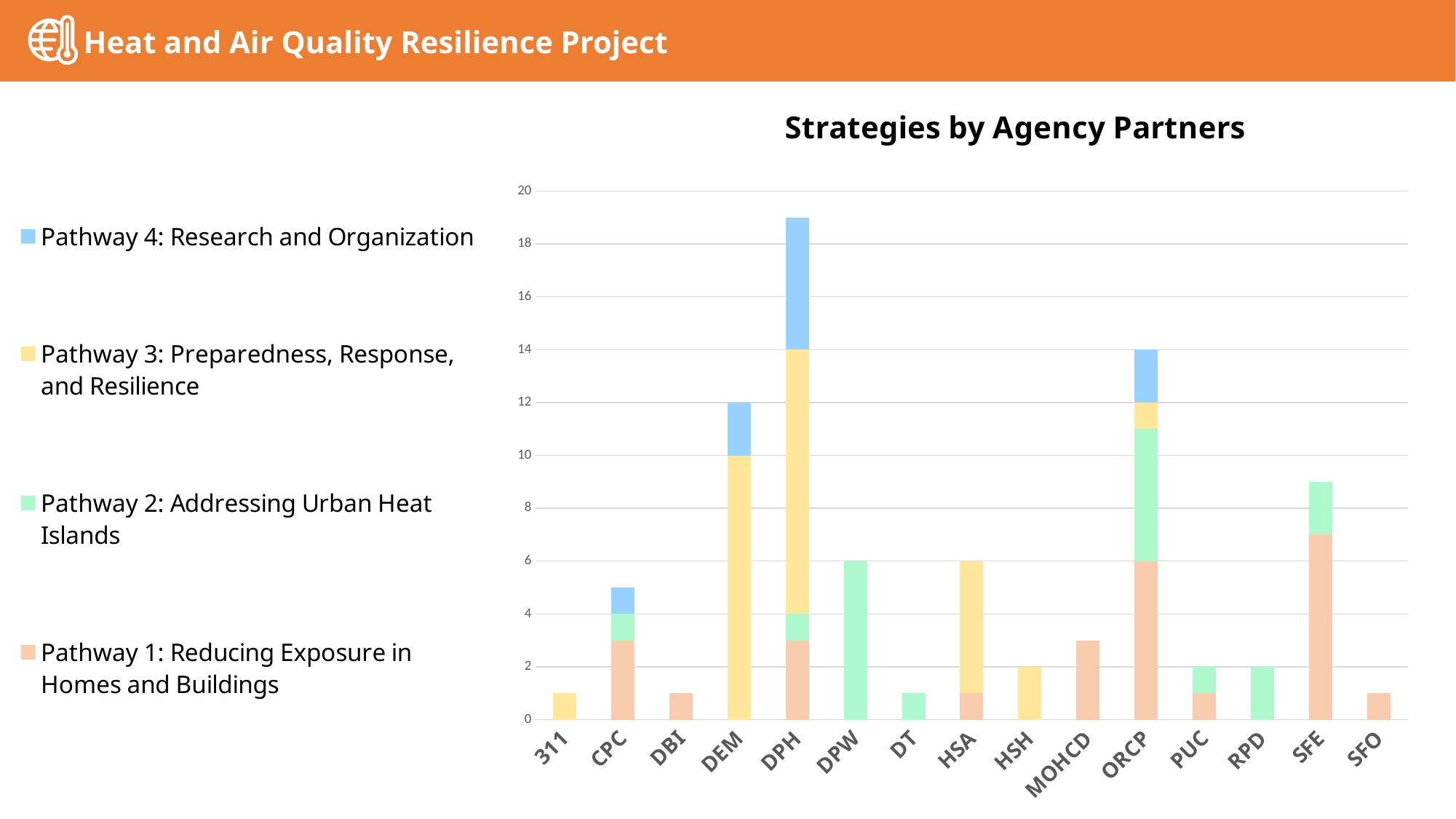
How many agency categories are shown on the x axis? 15 What colour represents Pathway 4: Research and Organization? Blue Which agency has the highest total number of strategies? DPH What kind of chart is shown on the slide? Stacked bar chart Is the total for DPH greater or less than 18? greater What is the difference between the totals for ORCP and DEM? 2 Which has a larger total, DEM or ORCP? ORCP What is the total number of strategies for ORCP? 14 Is the total for SFE greater or less than 8? greater What is the total number of strategies for DPW? 6 How many series does the legend list? 4 What is the total number of strategies for DEM? 12